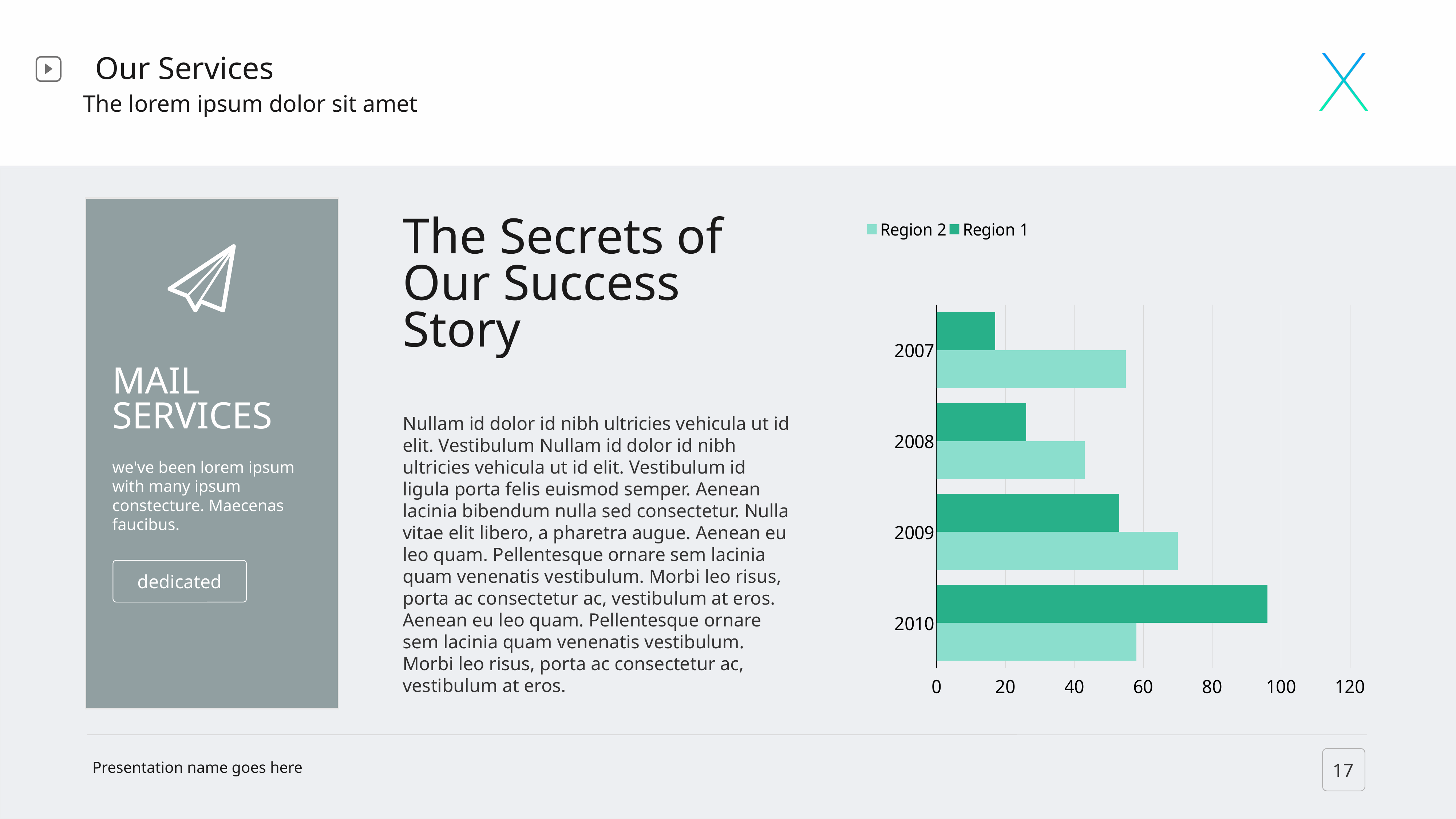
Which year has the lowest value for Region 2? 2008 Which year has the highest value for Region 1? 2010 How many series does the chart's legend list? 2 Which year has the lowest value for Region 1? 2007 Which year has the highest value for Region 2? 2009 How many years are shown on the chart's vertical axis? 4 Is the value for Region 1 in 2010 greater or less than 80? greater Do the values for Region 1 rise or fall from 2007 to 2010? rise What kind of chart is shown on the slide? bar chart Which series are listed in the chart's legend? Region 2 and Region 1 Is the value for Region 1 in 2007 greater or less than 20? less In 2007, which is larger, Region 1 or Region 2? Region 2